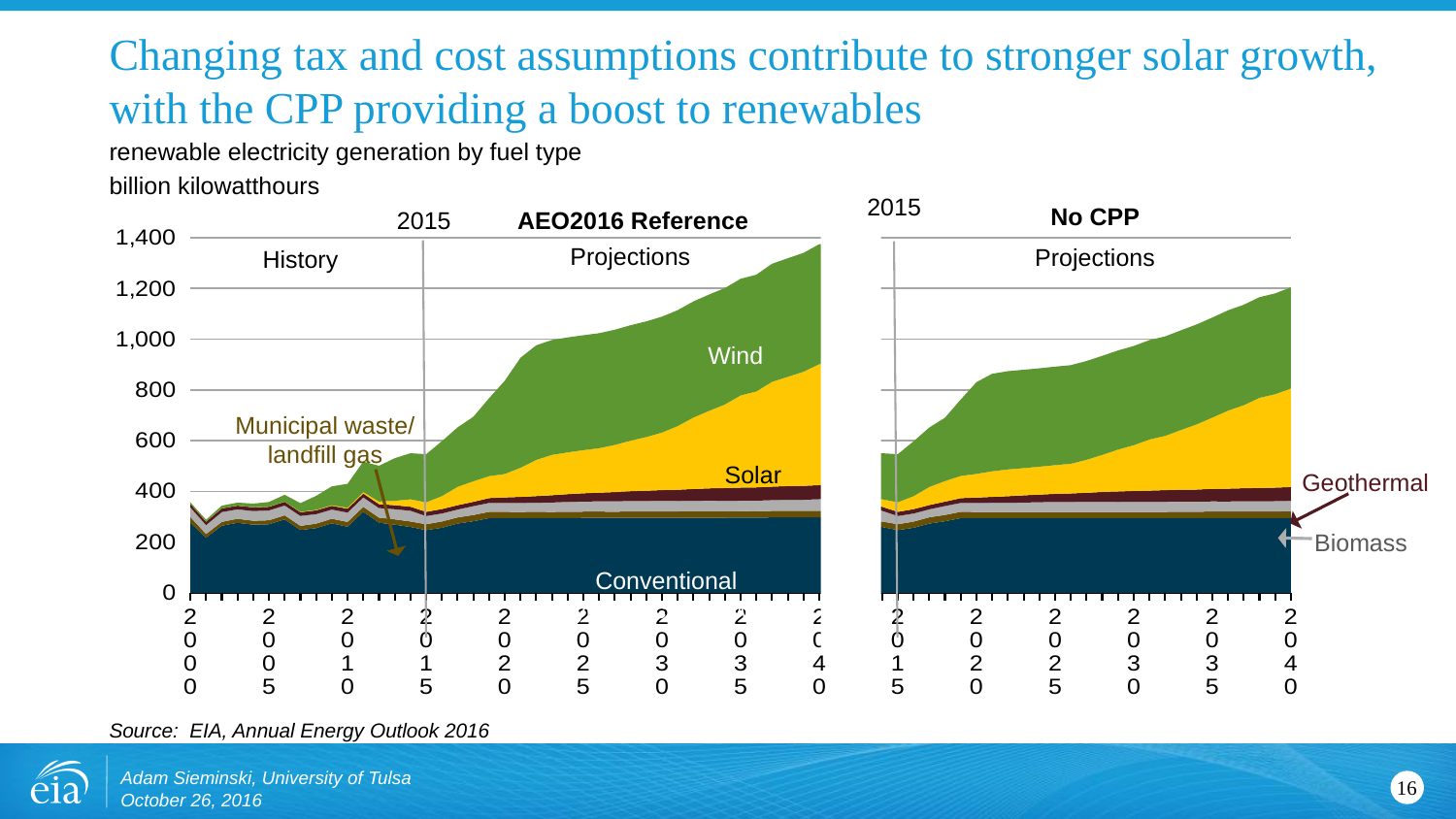
In the AEO2016 Reference chart, which fuel type forms the bottom (largest dark) layer of the stack? Conventional In the AEO2016 Reference chart, is the total renewable generation in 2040 greater or less than 1,200 billion kilowatthours? greater What is the first year shown on the x axis of the No CPP chart? 2015 In the No CPP chart, is the total renewable generation in 2040 greater or less than 1,000 billion kilowatthours? greater How many fuel types are labeled across the two charts? 6 In the AEO2016 Reference chart, is the total renewable generation in 2015 greater or less than 400 billion kilowatthours? greater What kind of chart is the AEO2016 Reference chart? stacked area chart In the AEO2016 Reference chart, which fuel type is the top layer of the stack in the projection period? Wind In the No CPP chart, does total renewable generation rise or fall from 2015 to 2040? rise What unit is used on the y axis of the charts? billion kilowatthours Which chart shows higher total renewable generation in 2040, AEO2016 Reference or No CPP? AEO2016 Reference